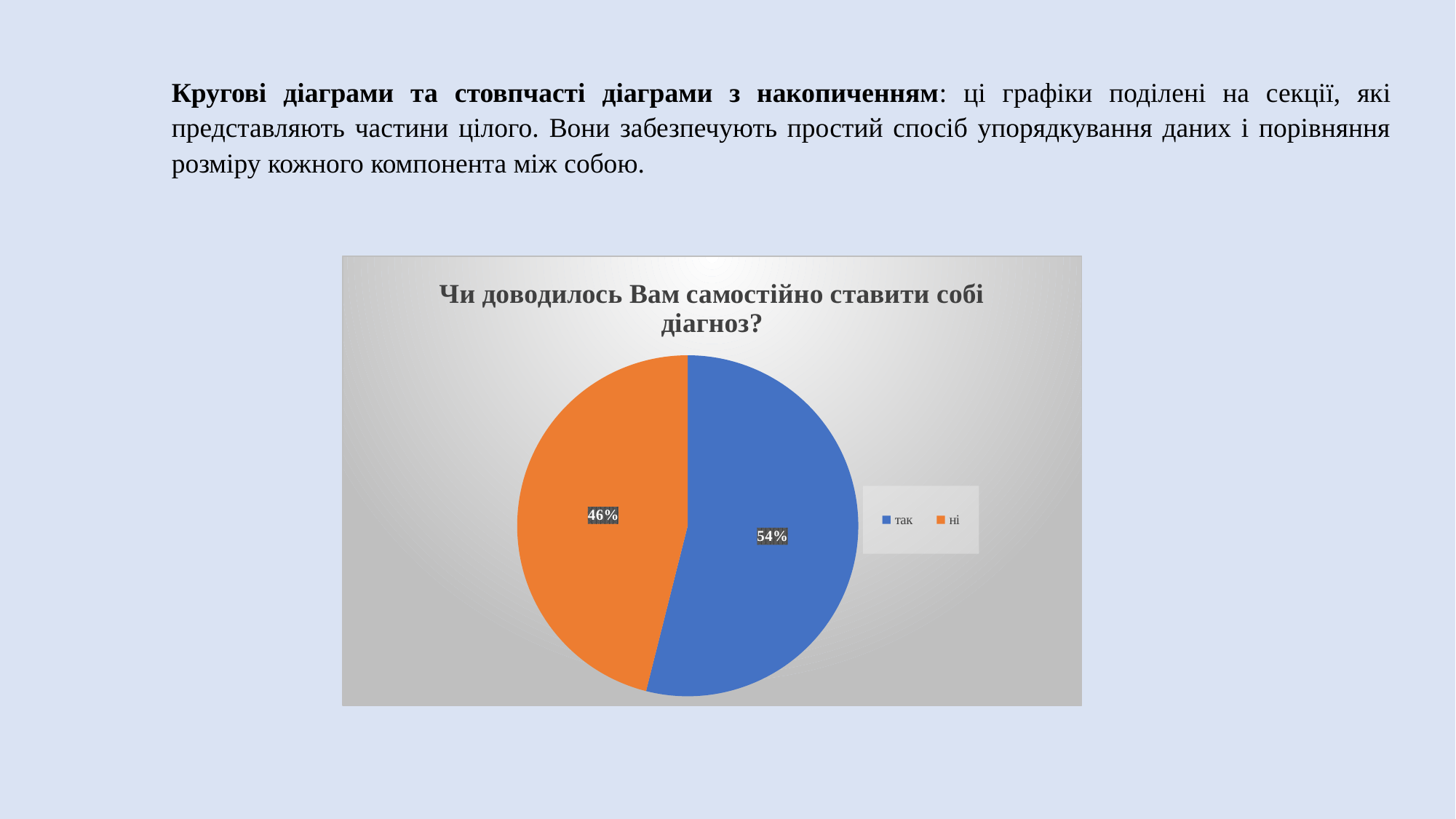
What is the title of the chart? Чи доводилось Вам самостійно ставити собі діагноз? Which slice is the smallest? ні By how many percentage points does "так" exceed "ні"? 8% What share of the pie is labelled "так"? 54% Which is larger, the "так" slice or the "ні" slice? так What kind of chart is shown on the slide? pie chart How many entries does the legend list? 2 Which slice is the largest? так Is the share for "так" greater or less than 50%? greater What share of the pie is labelled "ні"? 46% What colour is the "ні" slice? orange How many slices does the pie chart have? 2